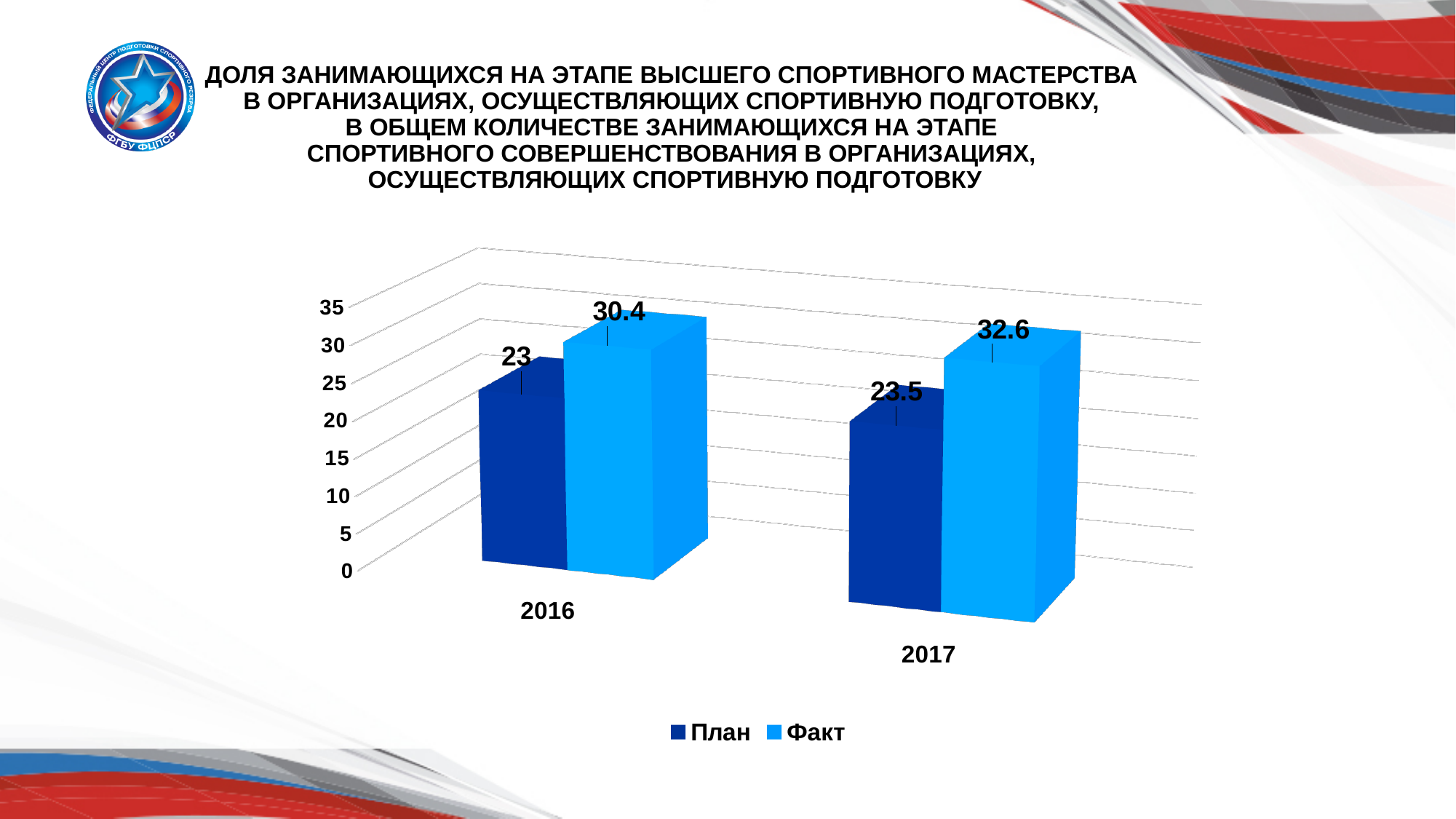
Which year has the highest Факт value? 2017 Which is larger in 2016, the План value or the Факт value? Факт What is the План value for 2017? 23.5 What is the difference between the Факт and План values for 2017? 9.1 What is the Факт value for 2016? 30.4 What is the План value for 2016? 23 How many series does the legend list? 2 What is the difference between the Факт values for 2017 and 2016? 2.2 Which year has the lowest План value? 2016 What is the Факт value for 2017? 32.6 How many years are shown on the x axis? 2 What kind of chart is shown on the slide? Bar chart